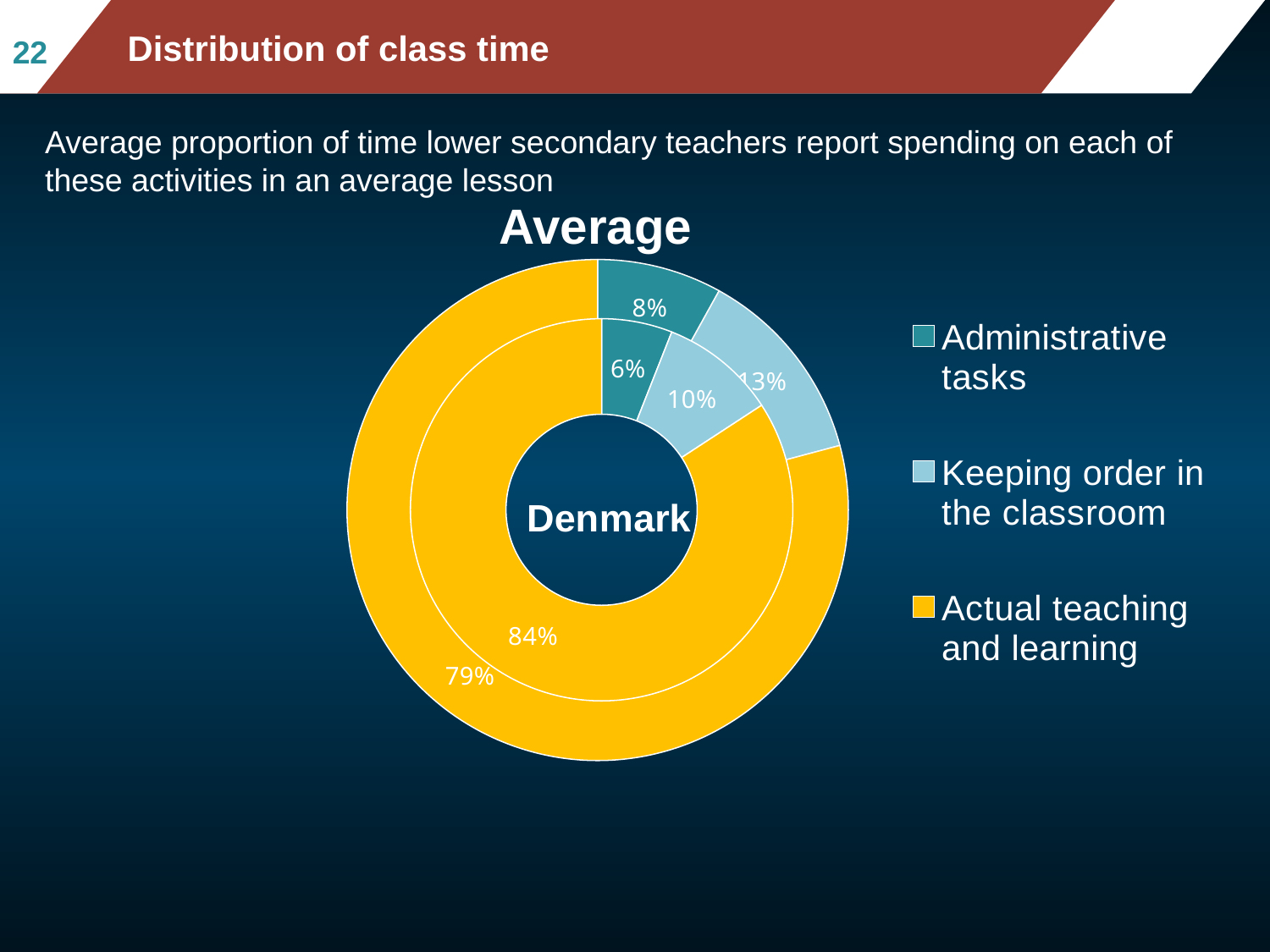
What proportion of time do Denmark's teachers report spending on keeping order in the classroom? 10% Which is larger: the share of time on administrative tasks in Denmark or the average share? Average What kind of chart is shown on the slide? Doughnut (pie) chart What is the average proportion of time spent on administrative tasks (outer ring)? 8% How many percentage points higher is Denmark's share for actual teaching and learning than the average share? 5 percentage points What proportion of time do Denmark's lower secondary teachers report spending on actual teaching and learning? 84% How many activities does the legend list? 3 What proportion of time do Denmark's teachers report spending on administrative tasks? 6% What is the average proportion of time spent on actual teaching and learning (outer ring)? 79% Which activity takes the smallest share of class time in the Denmark ring? Administrative tasks Which activity takes the largest share of class time in the Denmark ring? Actual teaching and learning Which ring of the doughnut chart shows the Denmark values, the inner or the outer? Inner ring